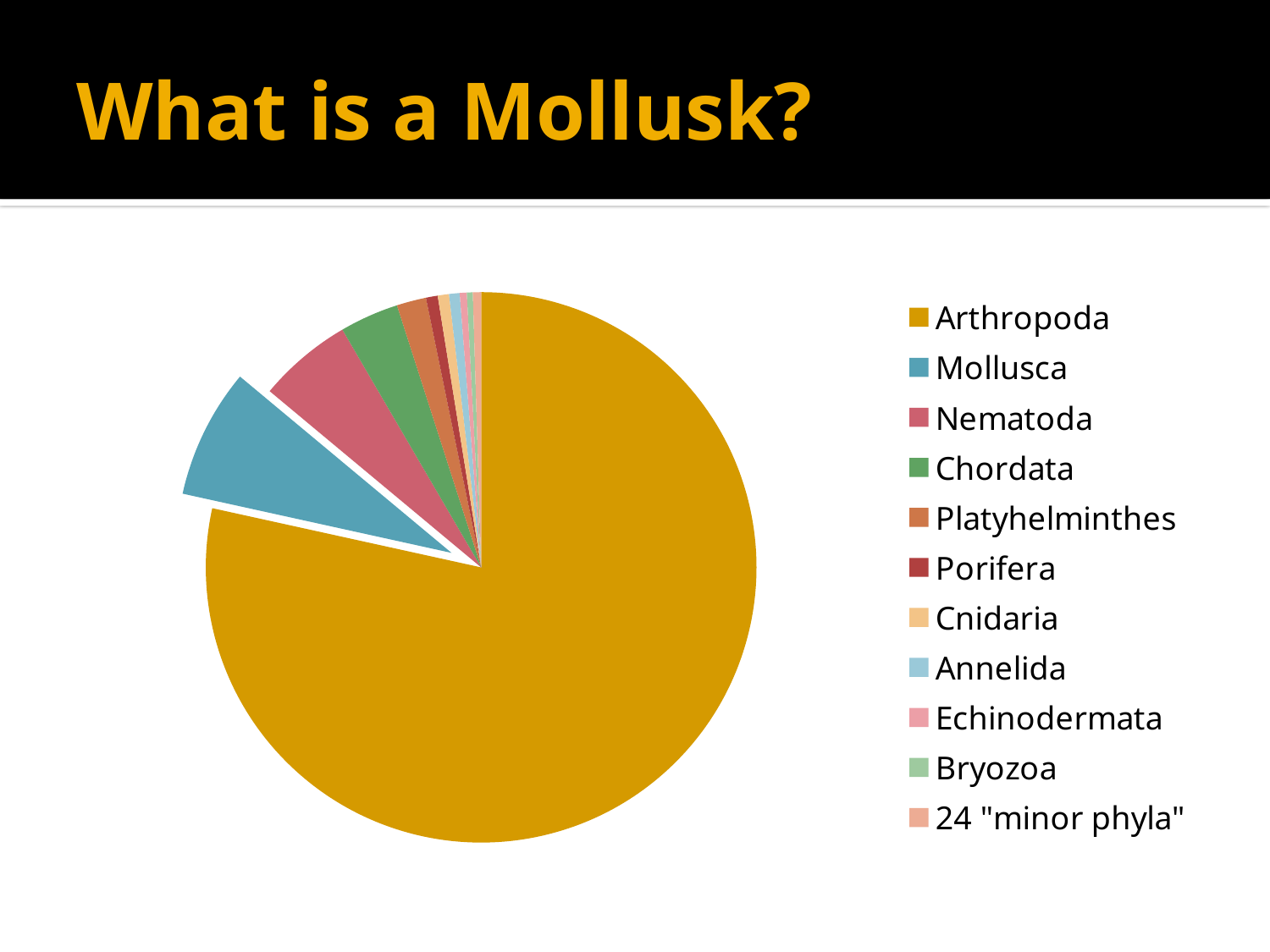
Which slice is larger, Chordata or Porifera? Chordata Which slice is larger, Nematoda or Chordata? Nematoda Which slice is larger, Mollusca or Nematoda? Mollusca What is the last entry listed in the pie chart's legend? 24 "minor phyla" What kind of chart is shown on the slide? pie chart How many categories does the pie chart's legend list? 11 Which category has the largest slice of the pie chart? Arthropoda Which slice is pulled out (exploded) from the rest of the pie chart? Mollusca